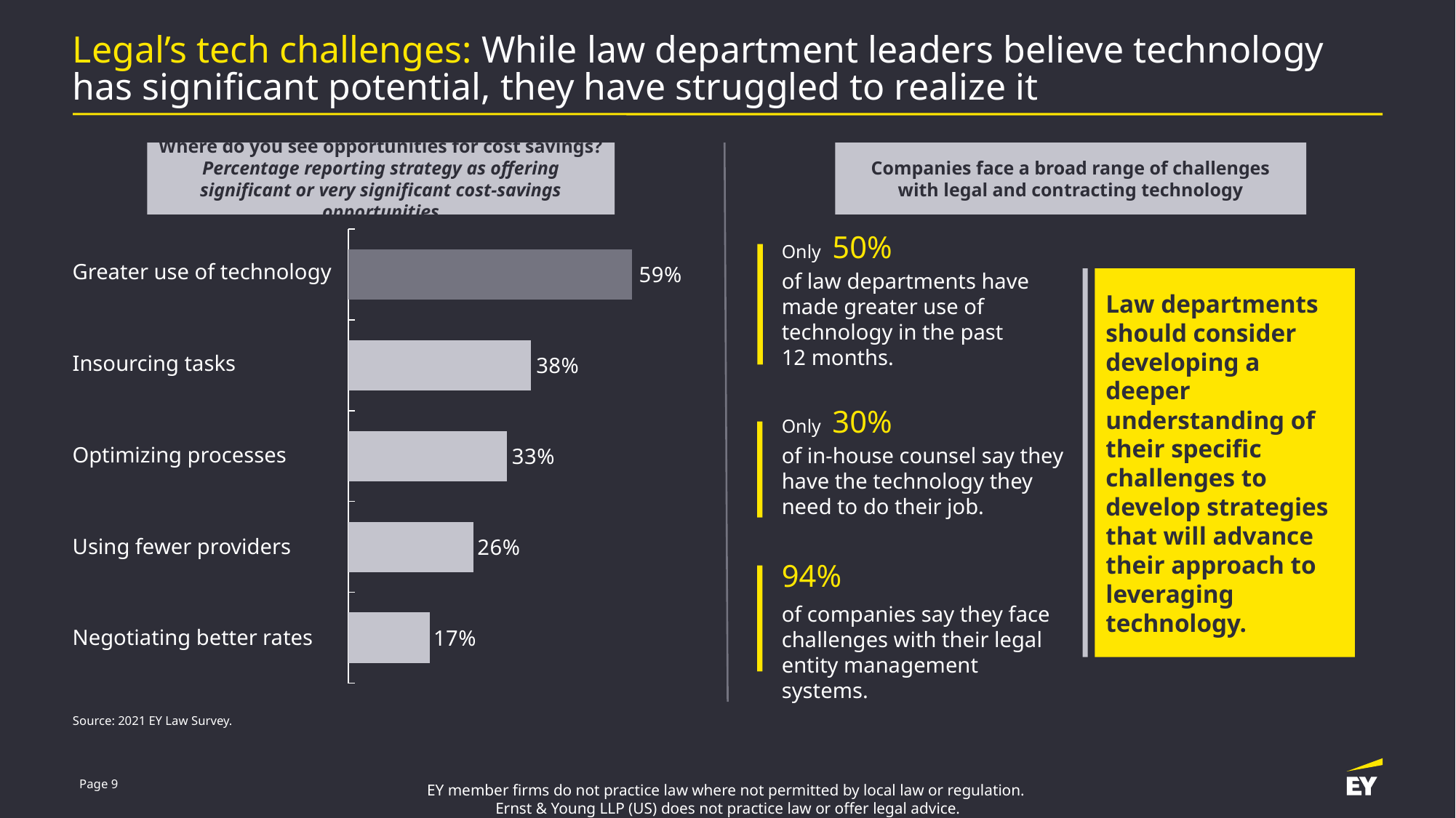
Which category has the highest percentage? Greater use of technology Which is larger, the percentage for Optimizing processes or for Using fewer providers? Optimizing processes What percentage is shown for Optimizing processes? 33% Which category has the lowest percentage? Negotiating better rates What percentage is shown for Using fewer providers? 26% How many categories are shown in the bar chart? 5 What percentage is shown for Negotiating better rates? 17% What percentage is shown for Insourcing tasks? 38% What percentage is shown for Greater use of technology? 59% What type of chart is shown on the slide? Bar chart What is the difference between the percentages for Greater use of technology and Insourcing tasks? 21% What is the source cited for the chart? 2021 EY Law Survey